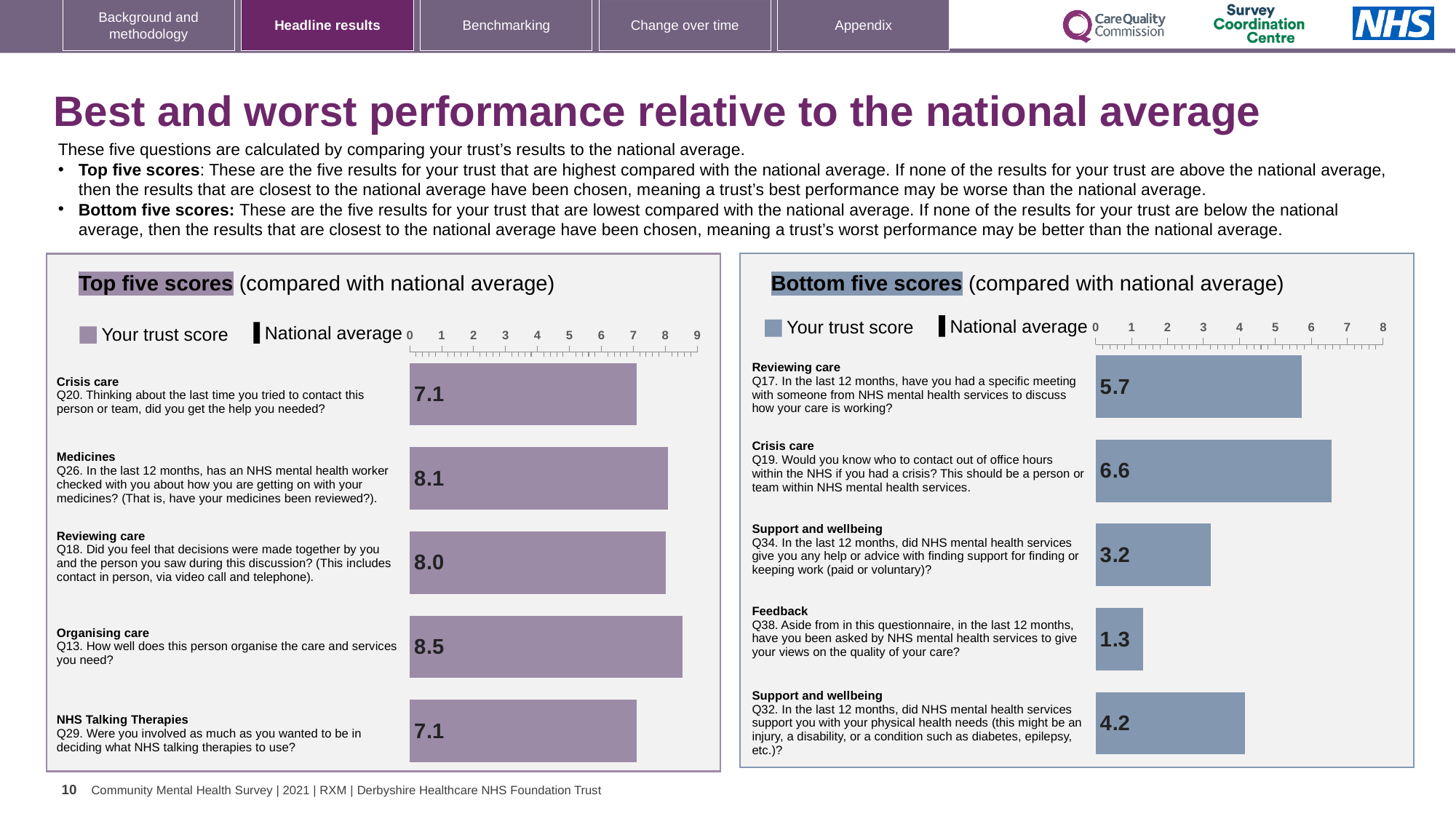
How many questions are plotted in the Bottom five scores chart? 5 In the Bottom five scores chart, which question has the highest trust score? Crisis care (Q19) In the Top five scores chart, what is the difference between the scores for Organising care (Q13) and Crisis care (Q20)? 1.4 In the Bottom five scores chart, which question has the lowest trust score? Feedback (Q38) In the Bottom five scores chart, which has the larger score: Support and wellbeing (Q34) or Support and wellbeing (Q32)? Support and wellbeing (Q32) In the Top five scores chart, which question has the highest trust score? Organising care (Q13) In the Top five scores chart, what is the trust score for Medicines (Q26)? 8.1 What kind of chart is the Top five scores chart? Bar chart In the Bottom five scores chart, what is the trust score for Crisis care (Q19)? 6.6 In the Bottom five scores chart, what is the trust score for Feedback (Q38)? 1.3 In the Bottom five scores chart, what is the difference between the scores for Crisis care (Q19) and Feedback (Q38)? 5.3 In the Top five scores chart, what is the trust score for Organising care (Q13)? 8.5